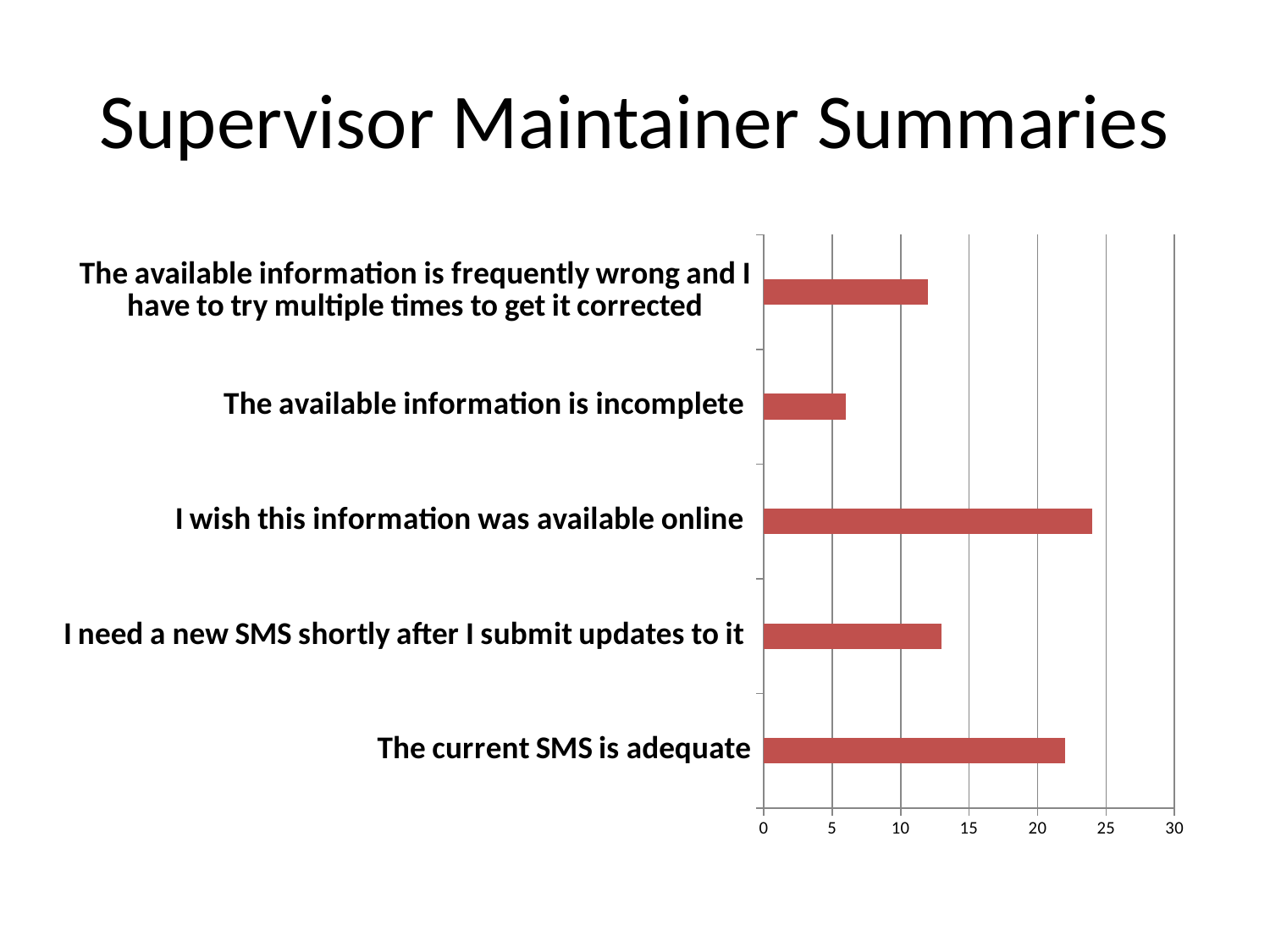
Is the value for "I wish this information was available online" greater or less than 20? greater How many categories are plotted in the chart? 5 Is the value for "I need a new SMS shortly after I submit updates to it" greater or less than 10? greater Which category has the shortest bar? The available information is incomplete What kind of chart is shown on the slide? bar chart What is the title of the slide containing the chart? Supervisor Maintainer Summaries Is the value for "The available information is frequently wrong and I have to try multiple times to get it corrected" greater or less than 15? less What is the maximum value shown on the horizontal axis? 30 Which category has the longest bar? I wish this information was available online Which is larger: the value for "The current SMS is adequate" or the value for "The available information is incomplete"? The current SMS is adequate